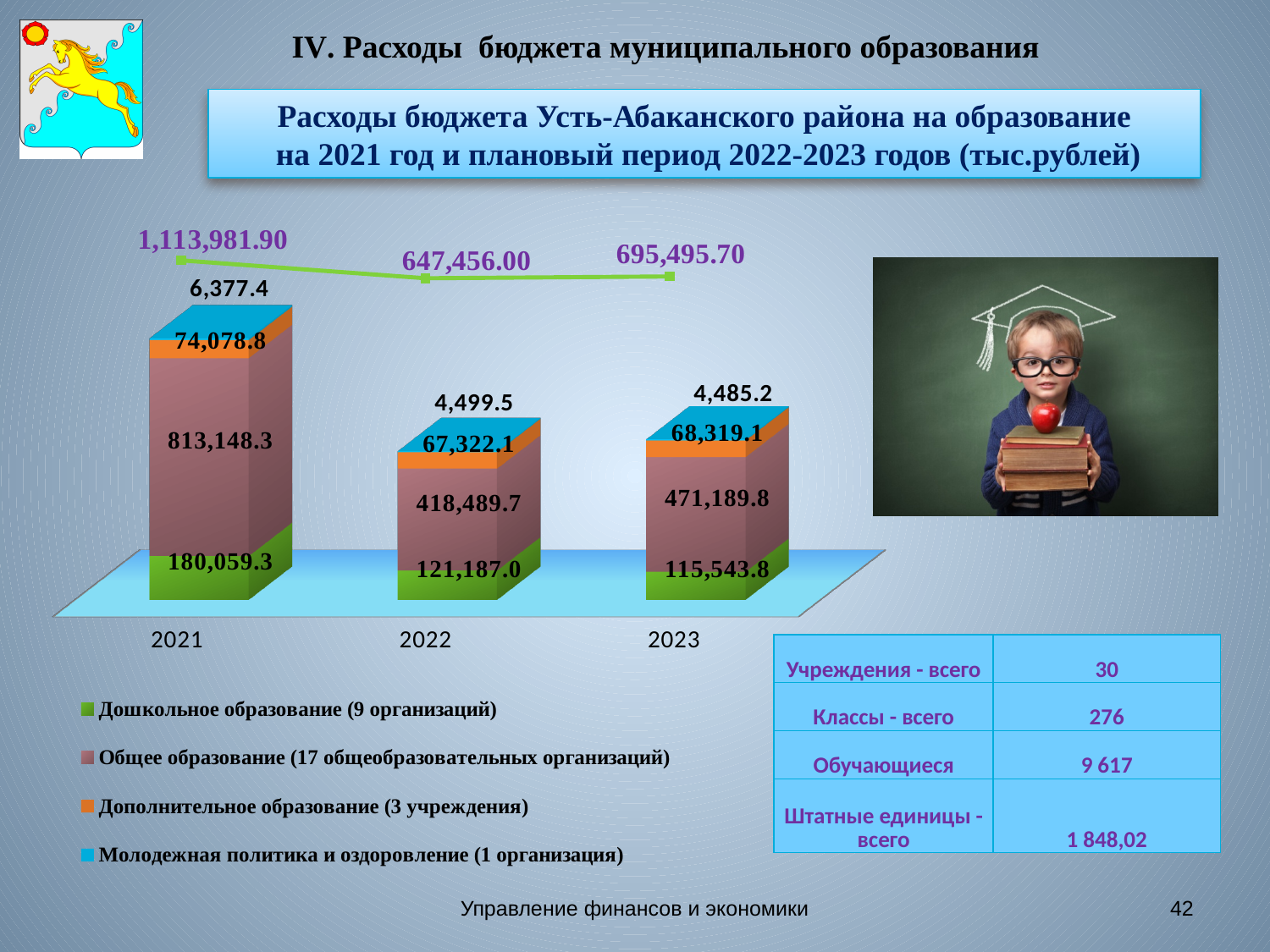
What value is labelled on the line above the 2022 bar? 647,456.00 In which year is the value for Общее образование the highest? 2021 What is the value for Молодежная политика и оздоровление in 2021? 6,377.4 What is the value for Дополнительное образование in 2022? 67,322.1 What kind of chart is used to show the education expenditures? Stacked bar chart Which year has the larger value for Дополнительное образование, 2021 or 2023? 2021 By how much does Общее образование in 2023 exceed Общее образование in 2022? 52,700.1 What is the value for Общее образование in 2021? 813,148.3 What is the value for Дошкольное образование in 2023? 115,543.8 How many series does the legend list? 4 In which year is the value for Дошкольное образование the lowest? 2023 How many years are shown on the x axis of the chart? 3